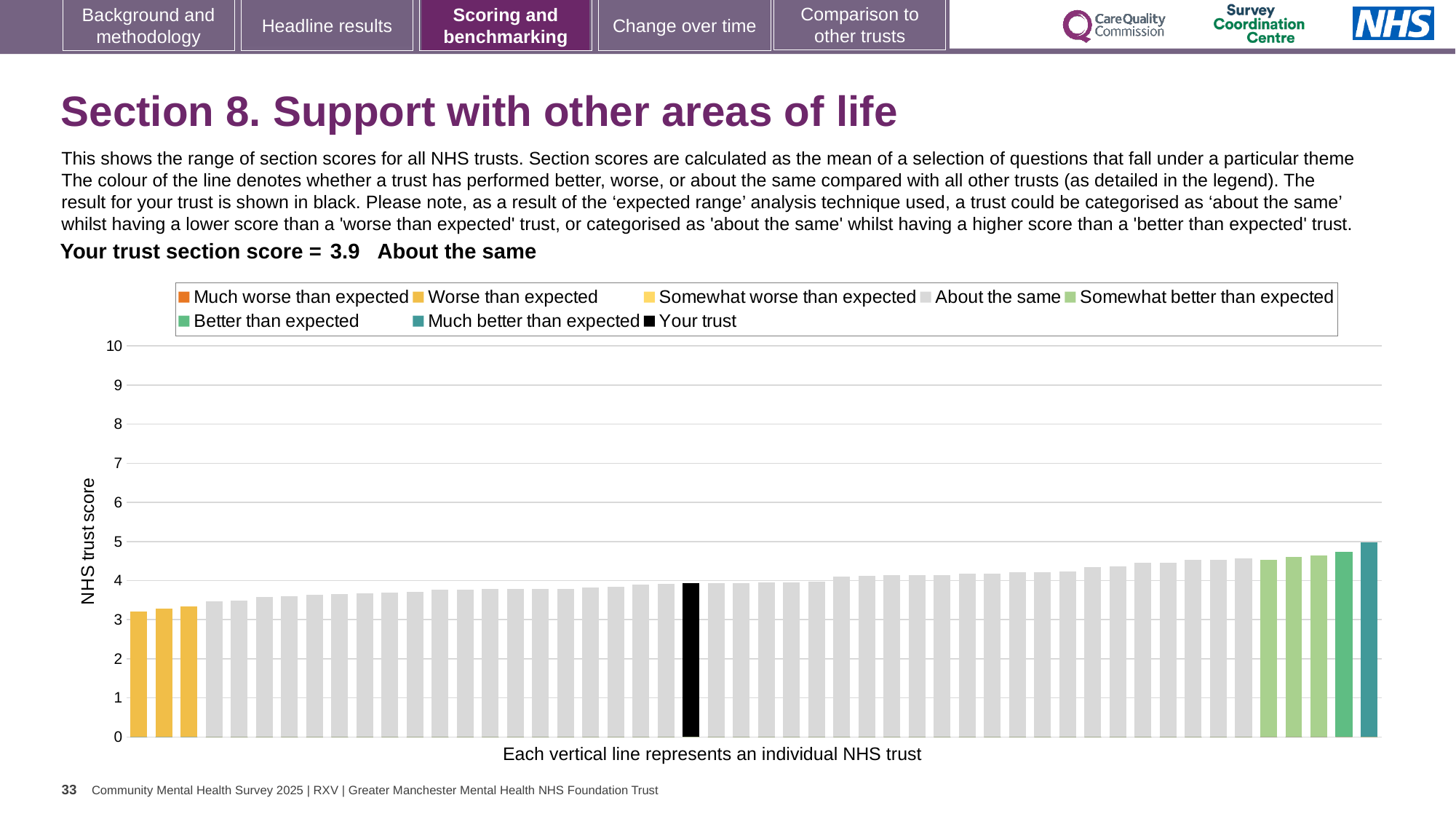
Is the value of the tallest bar greater or less than 6? less What is the label on the y axis of the chart? NHS trust score How many bars are coloured as 'Somewhat better than expected'? 3 How many bars are coloured as 'Worse than expected'? 3 What is the section score for your trust? 3.9 Do the bar values rise or fall from left to right along the x axis? rise Is the value of the shortest bar greater or less than 3? greater How many entries does the chart legend list? 8 Which category is your trust's section score placed in? About the same Is the value of the tallest bar greater or less than 4? greater Which legend category does the highest-scoring trust belong to? Much better than expected What kind of chart is shown on the slide? bar chart